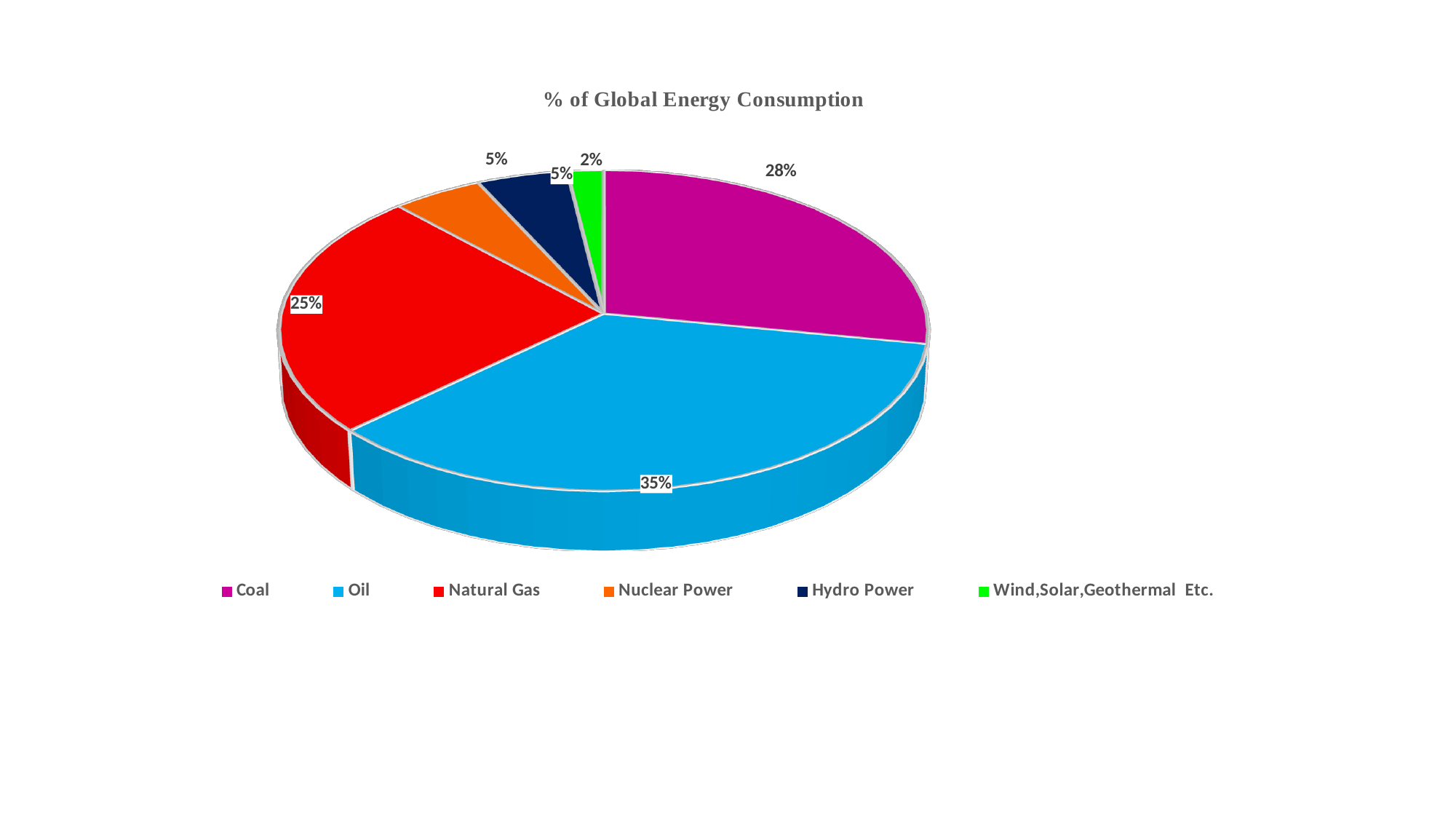
What is the difference in percentage points between Oil and Coal? 7% What is the title of the chart? % of Global Energy Consumption What percentage of global energy consumption does Oil account for? 35% What percentage of global energy consumption does Coal account for? 28% What percentage of global energy consumption does Natural Gas account for? 25% What kind of chart is shown on the slide? Pie chart How many categories does the pie chart show? 6 Which energy source has the smallest share of global energy consumption? Wind,Solar,Geothermal Etc. What colour is the Nuclear Power slice? Orange What percentage of global energy consumption does Wind,Solar,Geothermal Etc. account for? 2% Which has a larger share, Coal or Natural Gas? Coal Which energy source has the largest share of global energy consumption? Oil